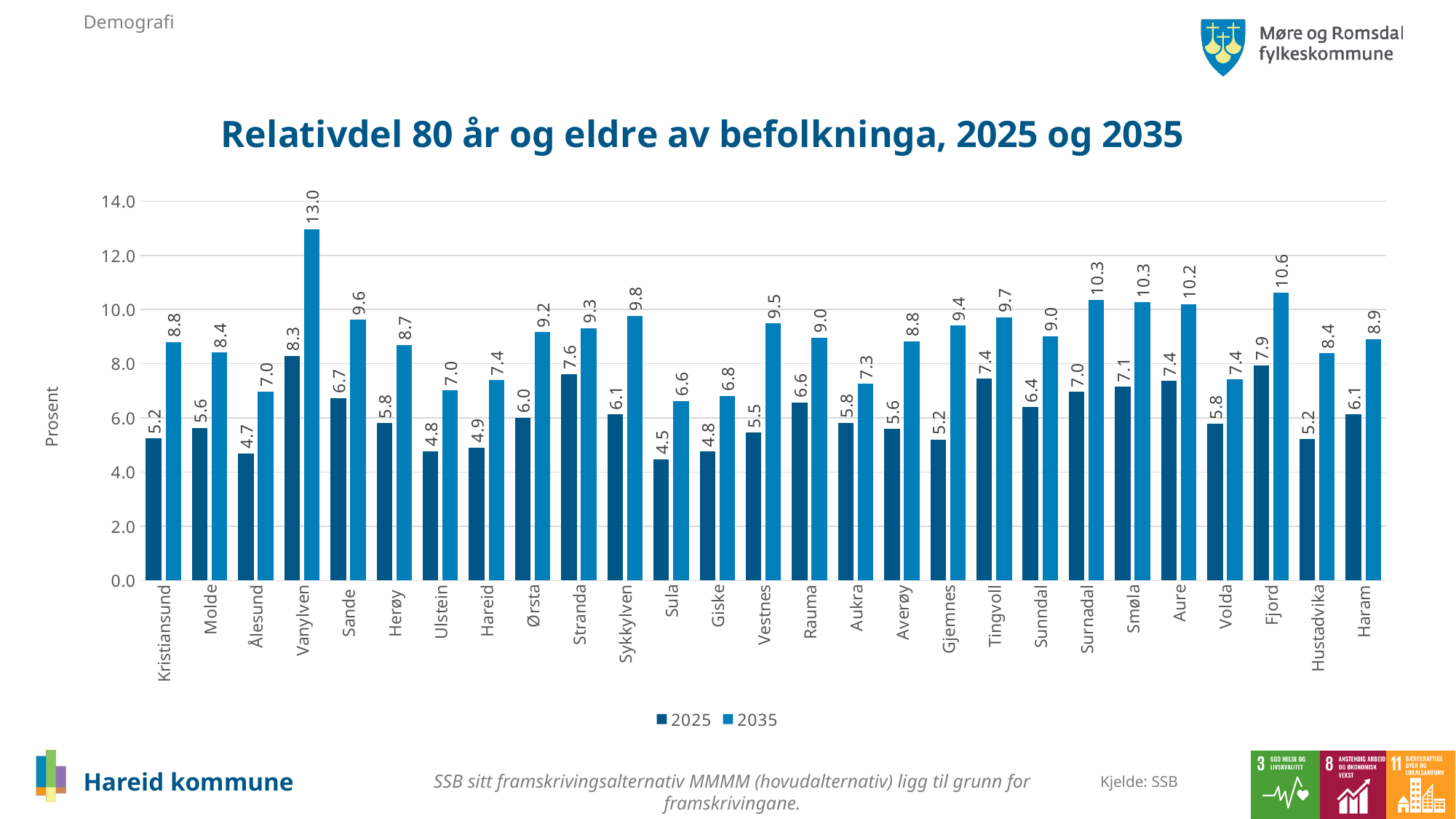
What is the value for Vanylven in the 2025 series? 8.3 What is the difference between the 2035 and 2025 values for Hareid? 2.5 Which municipality has the highest value in the 2035 series? Vanylven Which municipality has the lowest value in the 2025 series? Sula Which is larger: the 2025 value for Stranda or the 2025 value for Tingvoll? Stranda Is the 2035 value for Surnadal greater or less than 10.0? greater How many municipalities are shown on the x axis? 27 How many series does the legend list? 2 What is the value for Hareid in the 2035 series? 7.4 What is the value for Fjord in the 2035 series? 10.6 What is the difference between the 2035 values for Vanylven and Sula? 6.4 What kind of chart is shown on the slide? bar chart